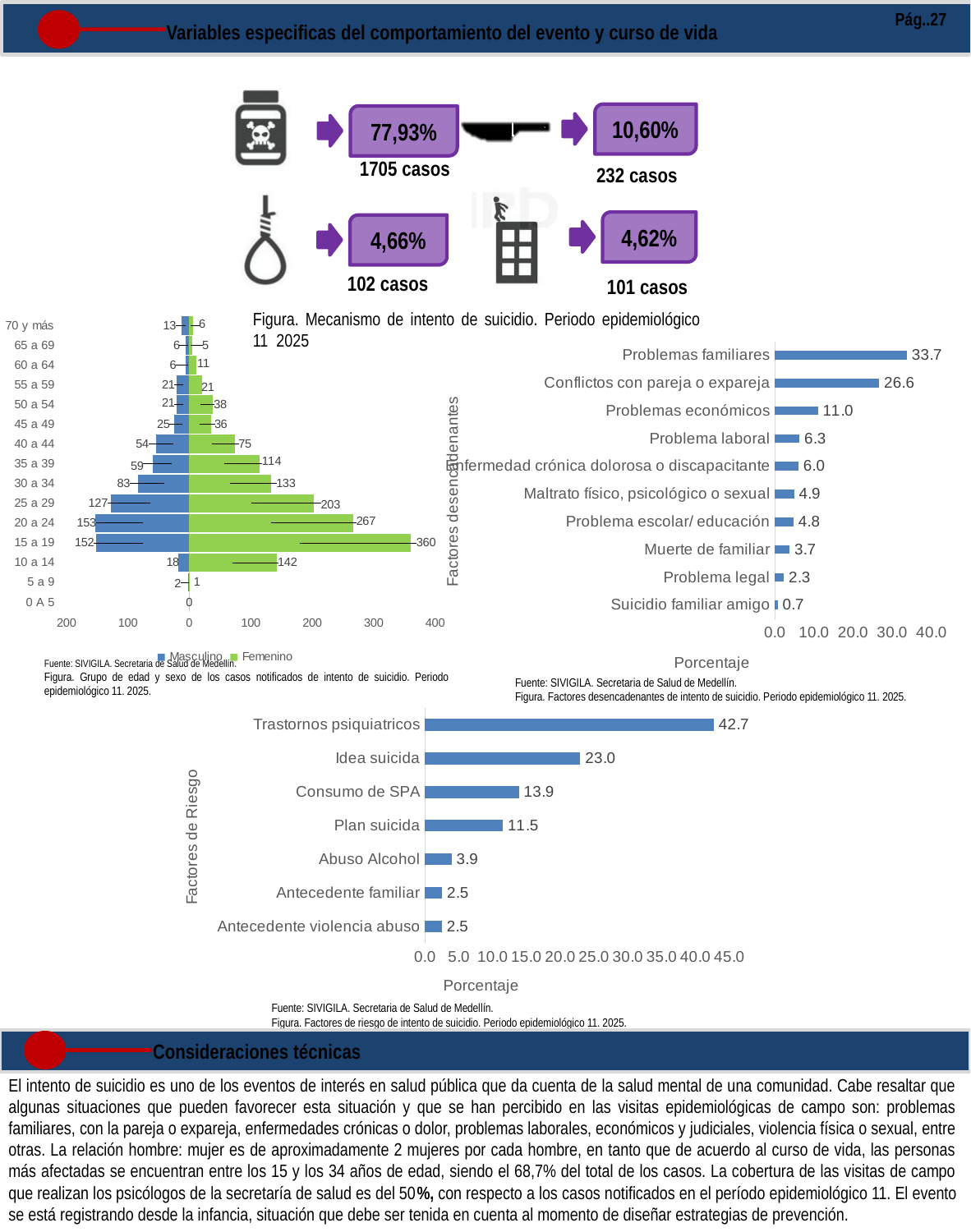
What kind of chart is the 'Factores de Riesgo' chart? Bar chart In the 'Factores de Riesgo' chart, which is larger, Consumo de SPA or Plan suicida? Consumo de SPA In the 'Factores desencadenantes' chart, what is the value for Problemas familiares? 33.7 How many categories are shown in the 'Factores desencadenantes' chart? 10 In the 'Factores desencadenantes' chart, what is the difference between Problemas familiares and Conflictos con pareja o expareja? 7.1 In the 'Factores de Riesgo' chart, what is the value for Trastornos psiquiatricos? 42.7 How many categories are shown in the 'Factores de Riesgo' chart? 7 In the age and sex chart (Grupo de edad y sexo), what is the Femenino value for the 15 a 19 age group? 360 How many series does the legend of the age and sex chart (Grupo de edad y sexo) list? 2 In the 'Factores desencadenantes' chart, which category has the lowest value? Suicidio familiar amigo In the age and sex chart (Grupo de edad y sexo), what is the Masculino value for the 20 a 24 age group? 153 In the age and sex chart (Grupo de edad y sexo), what is the difference between the Femenino and Masculino values for the 25 a 29 age group? 76